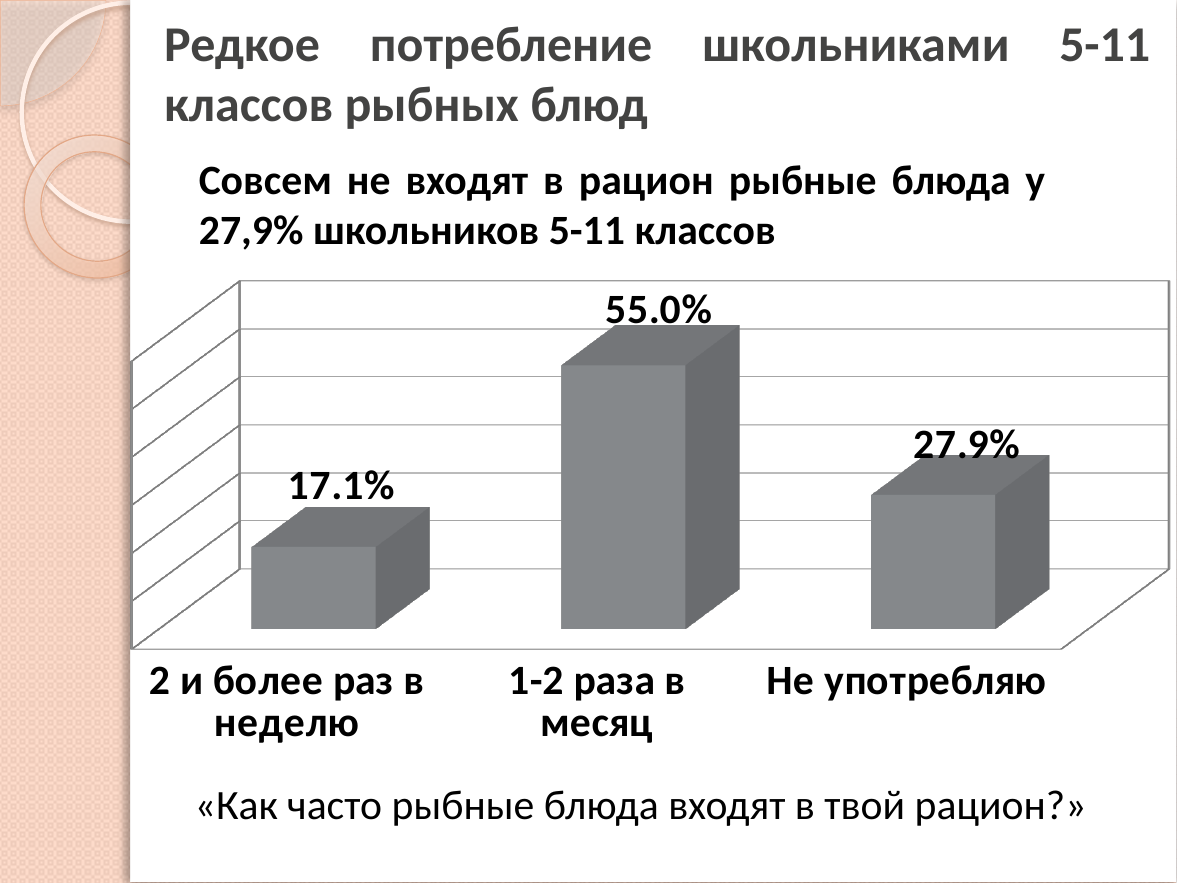
What kind of chart is shown on the slide? bar chart What is the value for "1-2 раза в месяц"? 55.0% What is the difference between the values for "1-2 раза в месяц" and "Не употребляю"? 27.1% How many categories are shown in the chart? 3 Which category has the lowest value? 2 и более раз в неделю What is the value for "Не употребляю"? 27.9% Which category has the highest value? 1-2 раза в месяц What question is written below the chart? «Как часто рыбные блюда входят в твой рацион?» Which is larger: the value for "Не употребляю" or the value for "2 и более раз в неделю"? Не употребляю What is the difference between the values for "Не употребляю" and "2 и более раз в неделю"? 10.8% What is the total of the three values shown in the chart? 100.0% What is the value for "2 и более раз в неделю"? 17.1%